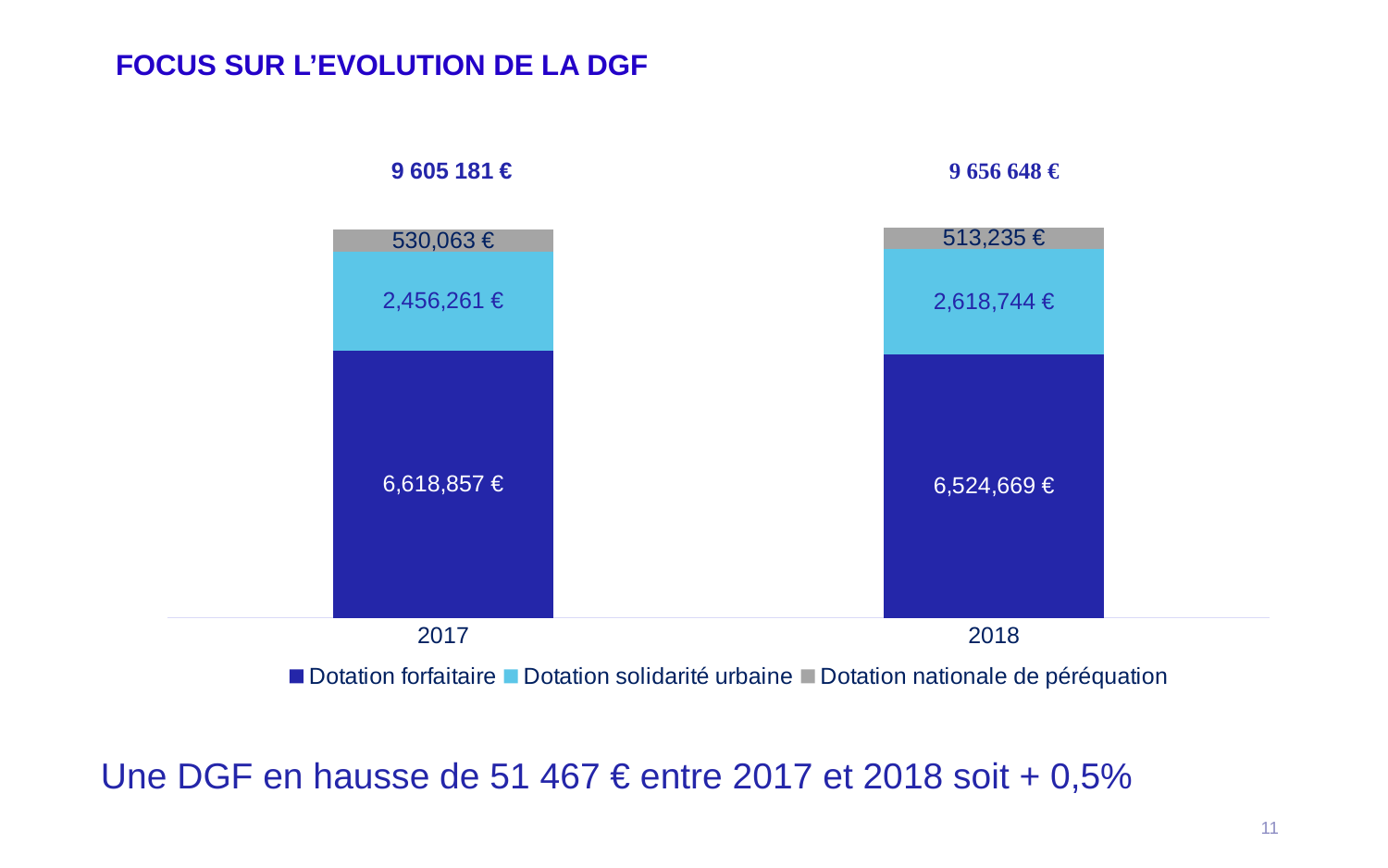
Which year has the larger Dotation forfaitaire, 2017 or 2018? 2017 How many series does the legend list? 3 Which series is the largest component of the 2018 bar? Dotation forfaitaire By how much did Dotation solidarité urbaine increase from 2017 to 2018? 162,483 € How many years (categories) are shown on the x axis? 2 What is the value of Dotation nationale de péréquation in 2017? 530,063 € What type of chart is shown on the slide? Stacked bar chart What is the total of the stacked bar for 2018? 9 656 648 € What is the total of the stacked bar for 2017? 9 605 181 € What is the difference in Dotation nationale de péréquation between 2017 and 2018? 16,828 € What is the value of Dotation solidarité urbaine in 2018? 2,618,744 € What is the value of Dotation forfaitaire in 2017? 6,618,857 €